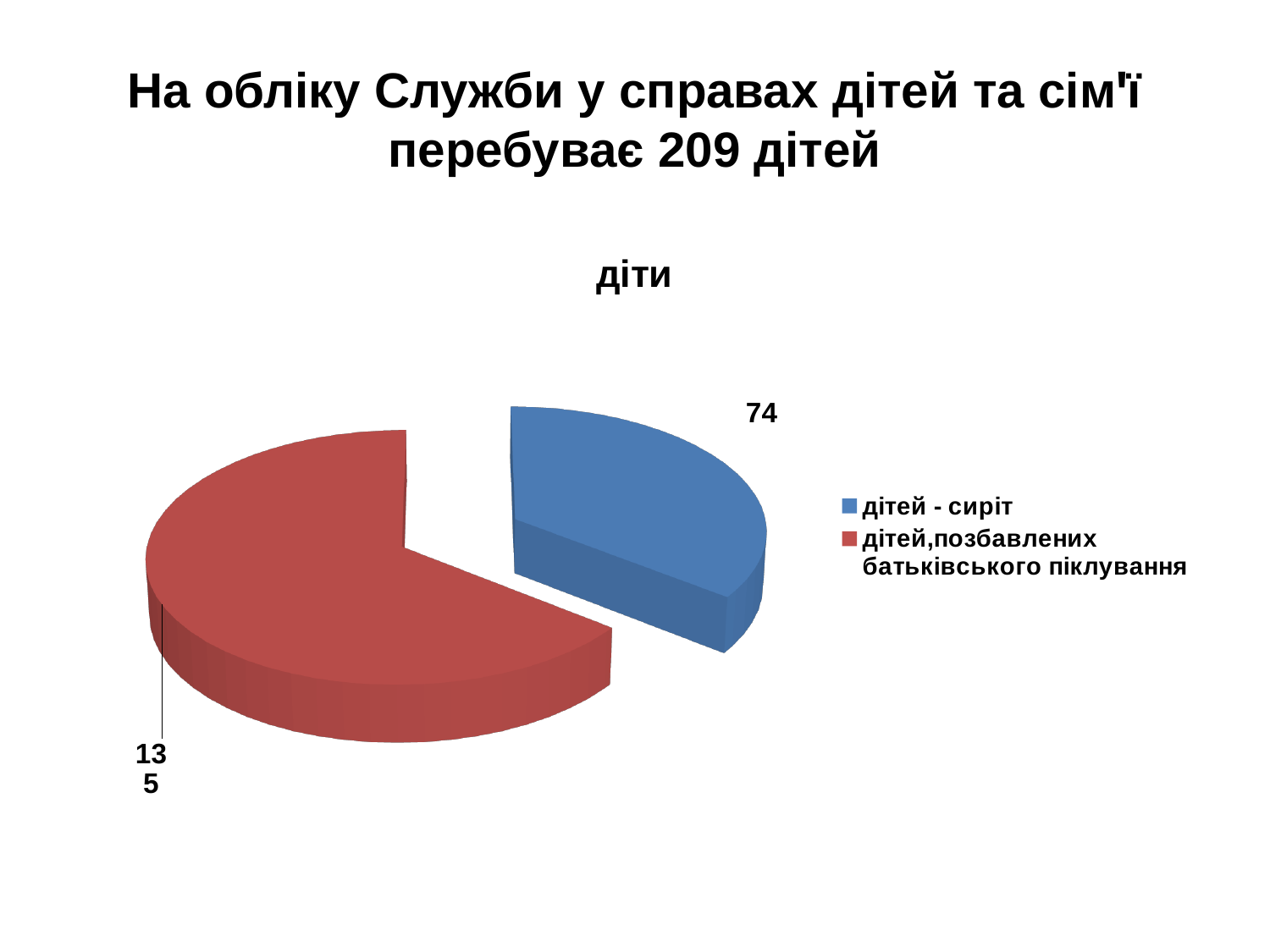
What is the difference between the value for дітей, позбавлених батьківського піклування and the value for дітей - сиріт? 61 Which is larger: the value for дітей - сиріт or the value for дітей, позбавлених батьківського піклування? дітей, позбавлених батьківського піклування What is the value for дітей - сиріт in the pie chart? 74 Which category has the smallest slice in the pie chart? дітей - сиріт What colour is the slice for дітей - сиріт? blue What kind of chart is shown on the slide? pie chart What is the total of the two values shown in the pie chart? 209 What share of the pie does the дітей - сиріт slice represent? 35.4% What is the title of the pie chart? діти How many slices does the pie chart have? 2 What is the value for дітей, позбавлених батьківського піклування in the pie chart? 135 Which category has the largest slice in the pie chart? дітей, позбавлених батьківського піклування